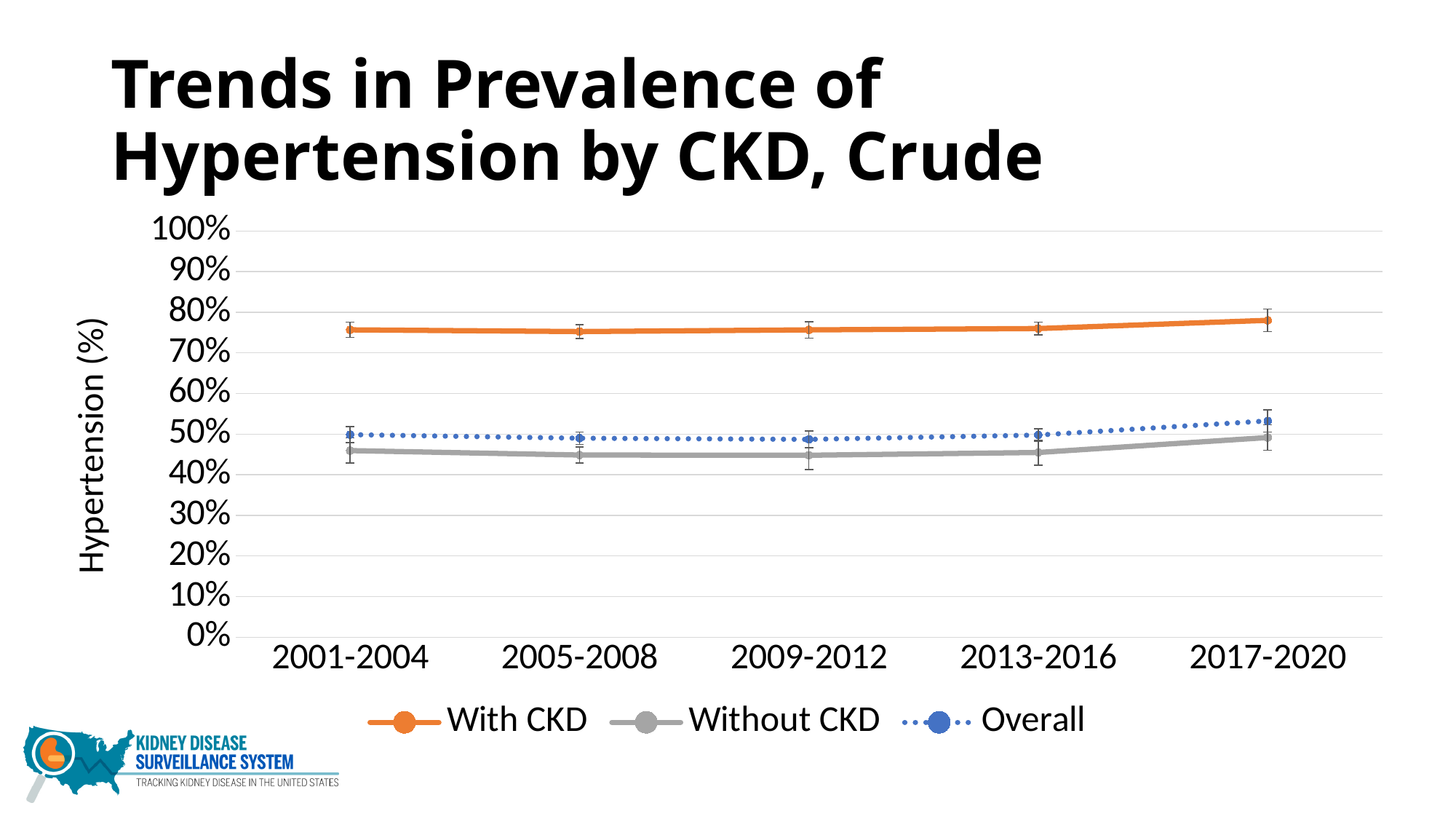
Is the value for With CKD in 2001-2004 greater or less than 70%? greater Is the value for Overall in 2017-2020 greater or less than 60%? less Which series has the lowest hypertension prevalence across all periods? Without CKD Does the With CKD line rise or fall from 2013-2016 to 2017-2020? rise Is the value for With CKD in 2017-2020 greater or less than 80%? less How many series does the legend list? 3 What kind of chart is shown on the slide? line chart How many time periods are shown on the x axis? 5 Which series has the highest hypertension prevalence across all periods? With CKD In 2013-2016, which is larger: the value for With CKD or the value for Without CKD? With CKD What is the label on the y axis? Hypertension (%)